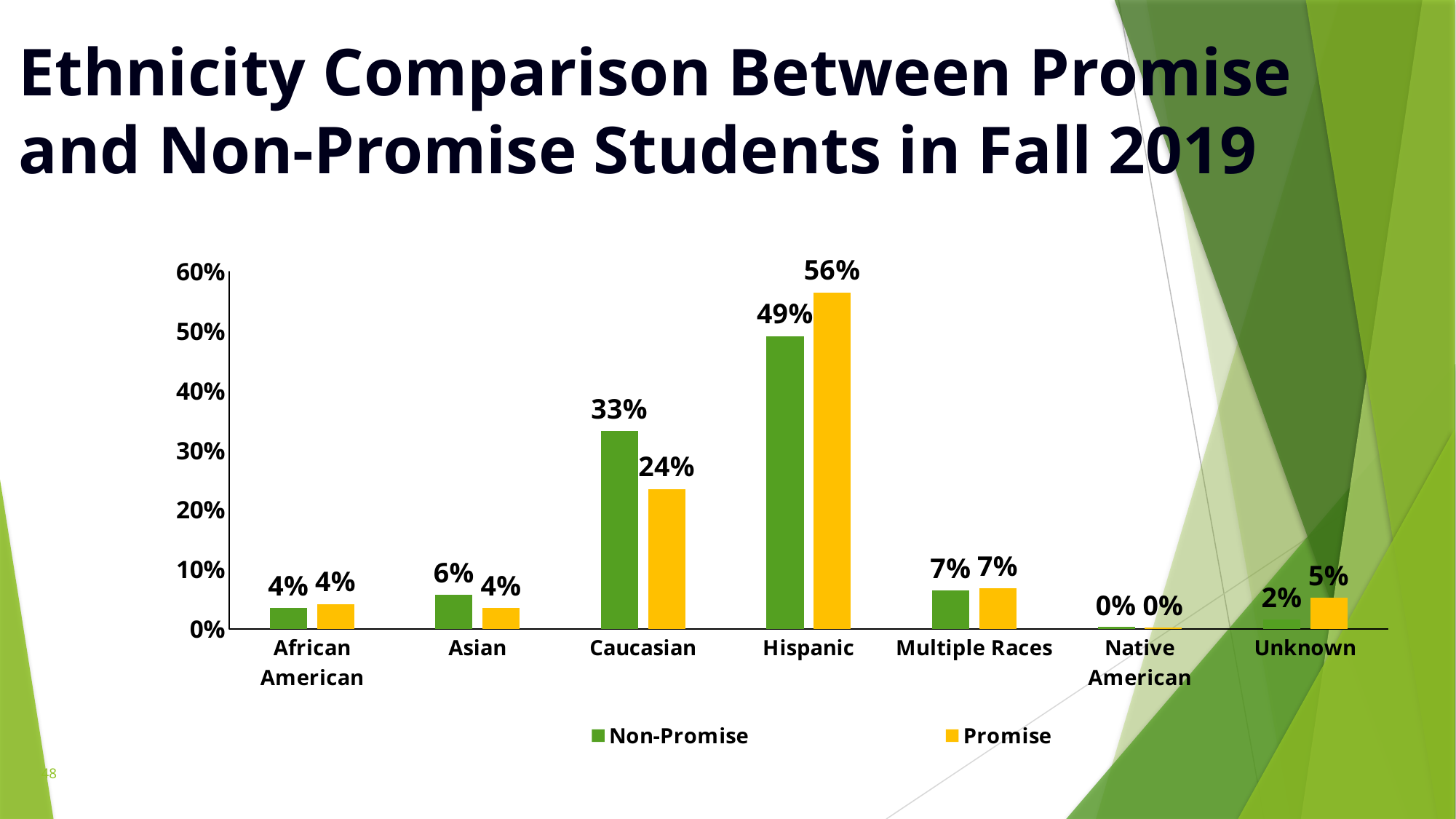
Is the Promise value for Hispanic greater or less than 50%? greater How many ethnicity categories are shown on the x axis? 7 What kind of chart is shown on the slide? Bar chart How many series does the legend list? 2 Which ethnicity has the lowest Promise value? Native American Which ethnicity has the highest Non-Promise value? Hispanic What is the Promise value for Hispanic? 56% What is the difference between the Promise and Non-Promise values for Hispanic? 7% What is the Non-Promise value for Caucasian? 33% What is the difference between the Non-Promise and Promise values for Caucasian? 9% Which is larger for Asian, the Non-Promise value or the Promise value? Non-Promise What is the Promise value for Unknown? 5%